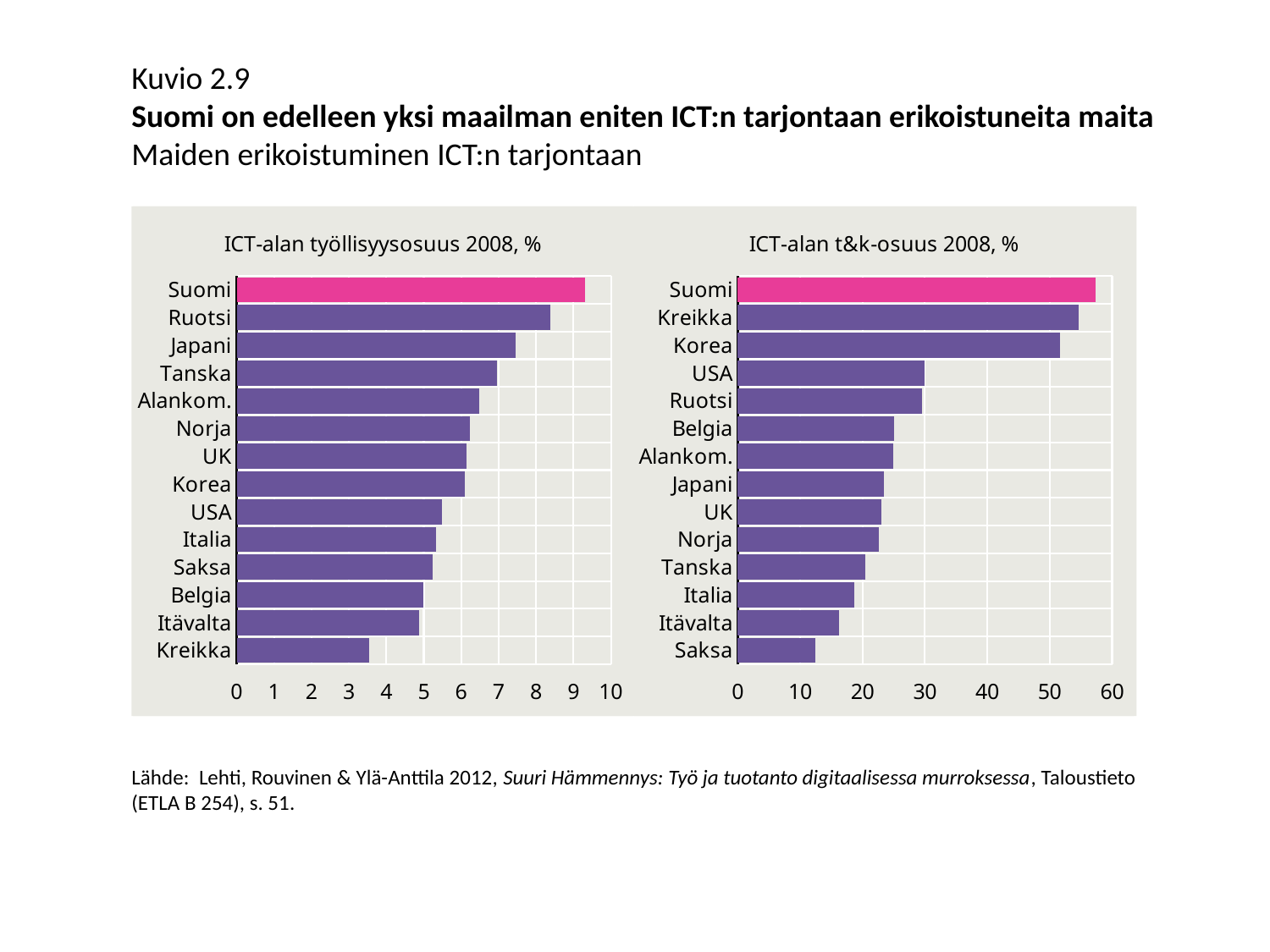
In the left chart (ICT-alan työllisyysosuus 2008, %), which is larger, the value for Ruotsi or the value for Belgia? Ruotsi In the right chart (ICT-alan t&k-osuus 2008, %), which country has the lowest value? Saksa How many countries are shown in the left chart (ICT-alan työllisyysosuus 2008, %)? 14 In the left chart (ICT-alan työllisyysosuus 2008, %), is the value for Suomi greater or less than 9? greater What kind of chart is the right chart (ICT-alan t&k-osuus 2008, %)? Bar chart In the left chart (ICT-alan työllisyysosuus 2008, %), which country has the lowest value? Kreikka In the left chart (ICT-alan työllisyysosuus 2008, %), is the value for Kreikka greater or less than 4? less In the right chart (ICT-alan t&k-osuus 2008, %), is the value for Itävalta greater or less than 20? less In the right chart (ICT-alan t&k-osuus 2008, %), which country has the highest value? Suomi In the right chart (ICT-alan t&k-osuus 2008, %), which is larger, the value for Kreikka or the value for Saksa? Kreikka In the left chart (ICT-alan työllisyysosuus 2008, %), which country has the highest value? Suomi